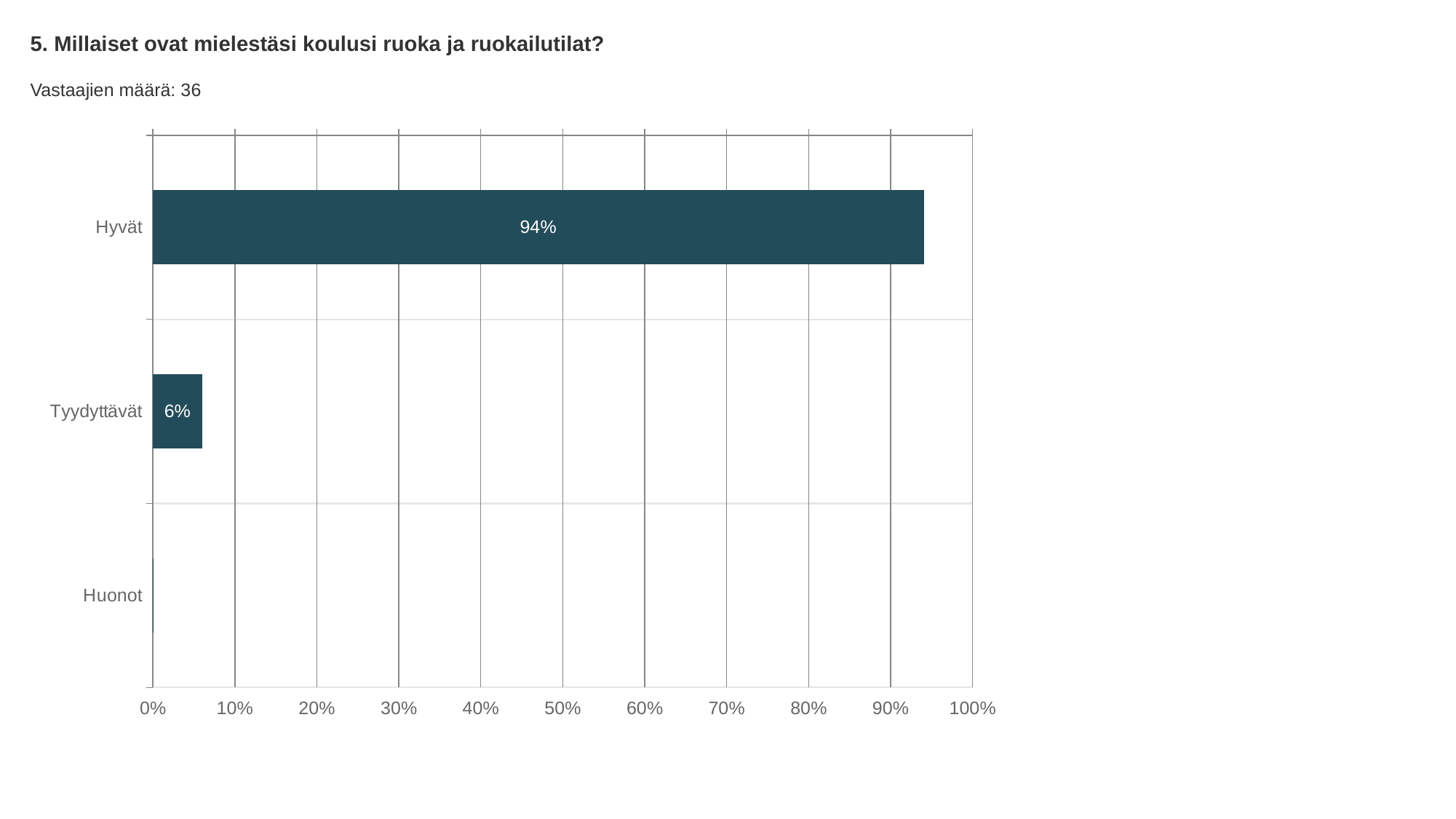
What is the value for Tyydyttävät? 6% Which is larger, the value for Hyvät or the value for Tyydyttävät? Hyvät What is the title of the chart? 5. Millaiset ovat mielestäsi koulusi ruoka ja ruokailutilat? What is the difference between the values for Hyvät and Tyydyttävät? 88% Which category has the lowest value? Huonot What kind of chart is shown on the slide? Bar chart How many categories are shown in the chart? 3 What is the value for Hyvät? 94% Which category has the highest value? Hyvät Is the value for Tyydyttävät greater or less than 10%? less How many respondents (Vastaajien määrä) does the slide report? 36 Is the value for Hyvät greater or less than 90%? greater